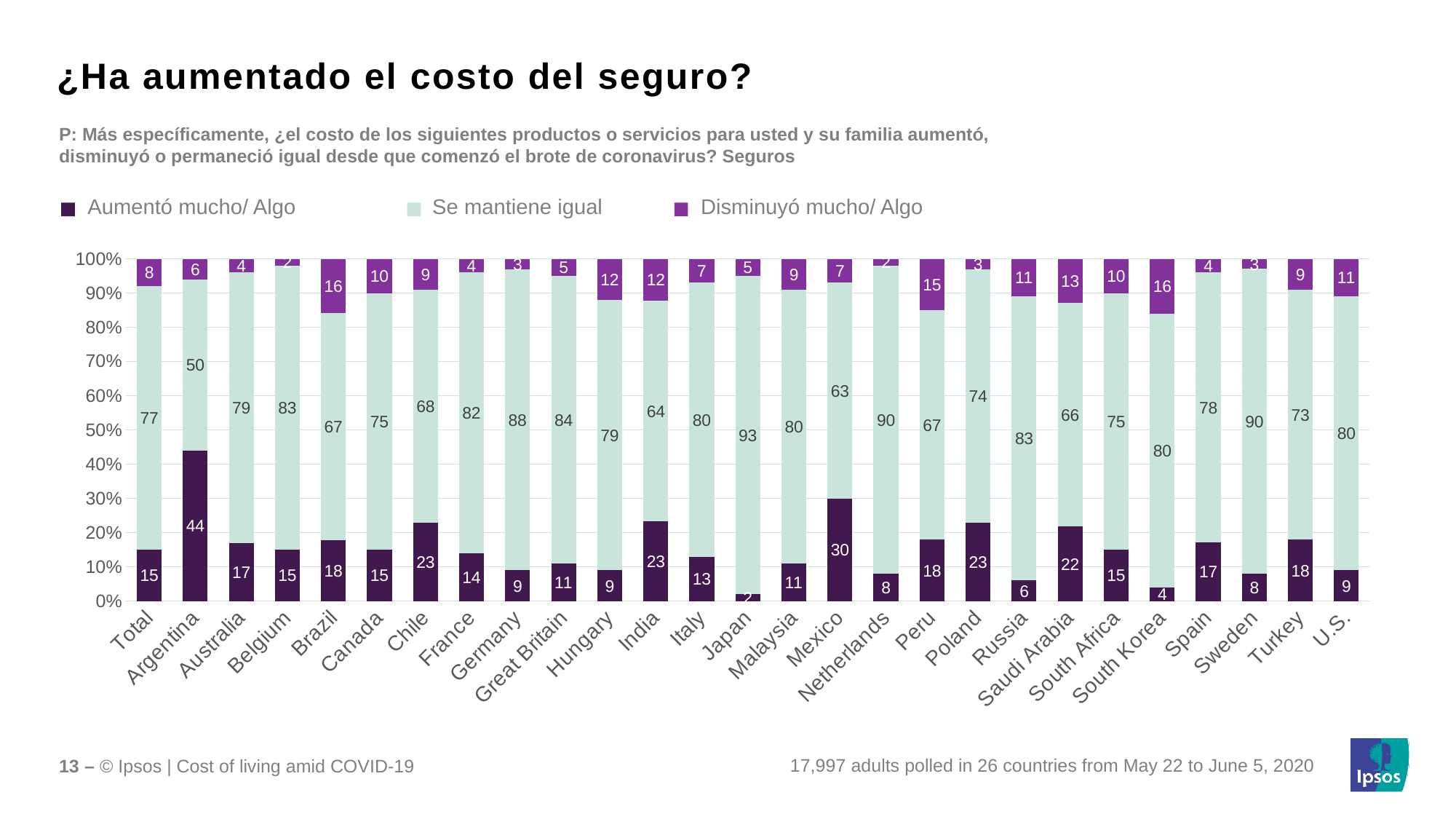
What is the 'Disminuyó mucho/ Algo' value for Brazil? 16 How many series does the legend list? 3 Which has a larger 'Disminuyó mucho/ Algo' value, Peru or Poland? Peru Which has a larger 'Aumentó mucho/ Algo' value, Chile or Italy? Chile Which country has the lowest 'Aumentó mucho/ Algo' value? Japan What percentage of respondents in Argentina said the cost of insurance 'Aumentó mucho/ Algo'? 44 Which country has the highest 'Aumentó mucho/ Algo' value? Argentina What is the 'Se mantiene igual' value for Japan? 93 What is the difference between the 'Aumentó mucho/ Algo' values for Mexico and Total? 15 How many categories are shown on the x axis of the chart? 27 What kind of chart is shown on the slide? Stacked bar chart Which country has the highest 'Se mantiene igual' value? Japan